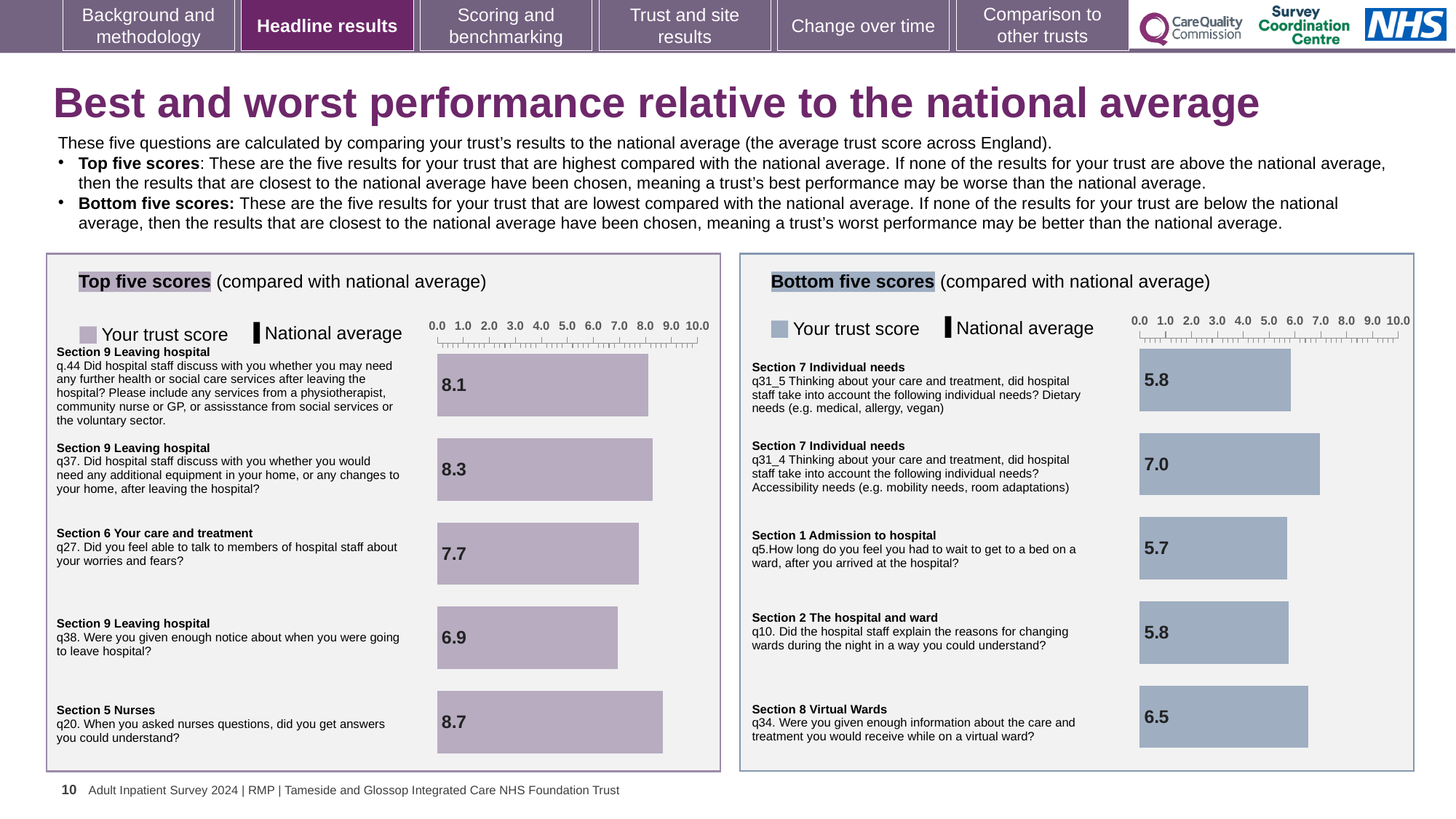
In the Top five scores chart, what is the trust score for q20 (When you asked nurses questions, did you get answers you could understand?)? 8.7 In the Top five scores chart, which question has the highest trust score? q20. When you asked nurses questions, did you get answers you could understand? In the Top five scores chart, what is the trust score for q38 (Were you given enough notice about when you were going to leave hospital?)? 6.9 In the Bottom five scores chart, which question has the highest trust score? q31_4 Accessibility needs (e.g. mobility needs, room adaptations) In the Bottom five scores chart, which question has the lowest trust score? q5. How long do you feel you had to wait to get to a bed on a ward, after you arrived at the hospital? In the Bottom five scores chart, what is the trust score for q31_4 (Accessibility needs)? 7.0 In the Top five scores chart, what is the difference between the trust scores for q37 and q27? 0.6 In the Bottom five scores chart, what is the trust score for q34 (Were you given enough information about the care and treatment you would receive while on a virtual ward?)? 6.5 In the Bottom five scores chart, which is larger: the trust score for q31_4 or for q34? q31_4 How many bars are shown in the Top five scores chart? 5 In the Top five scores chart, which question has the lowest trust score? q38. Were you given enough notice about when you were going to leave hospital? What type of chart is used for the Bottom five scores? Bar chart